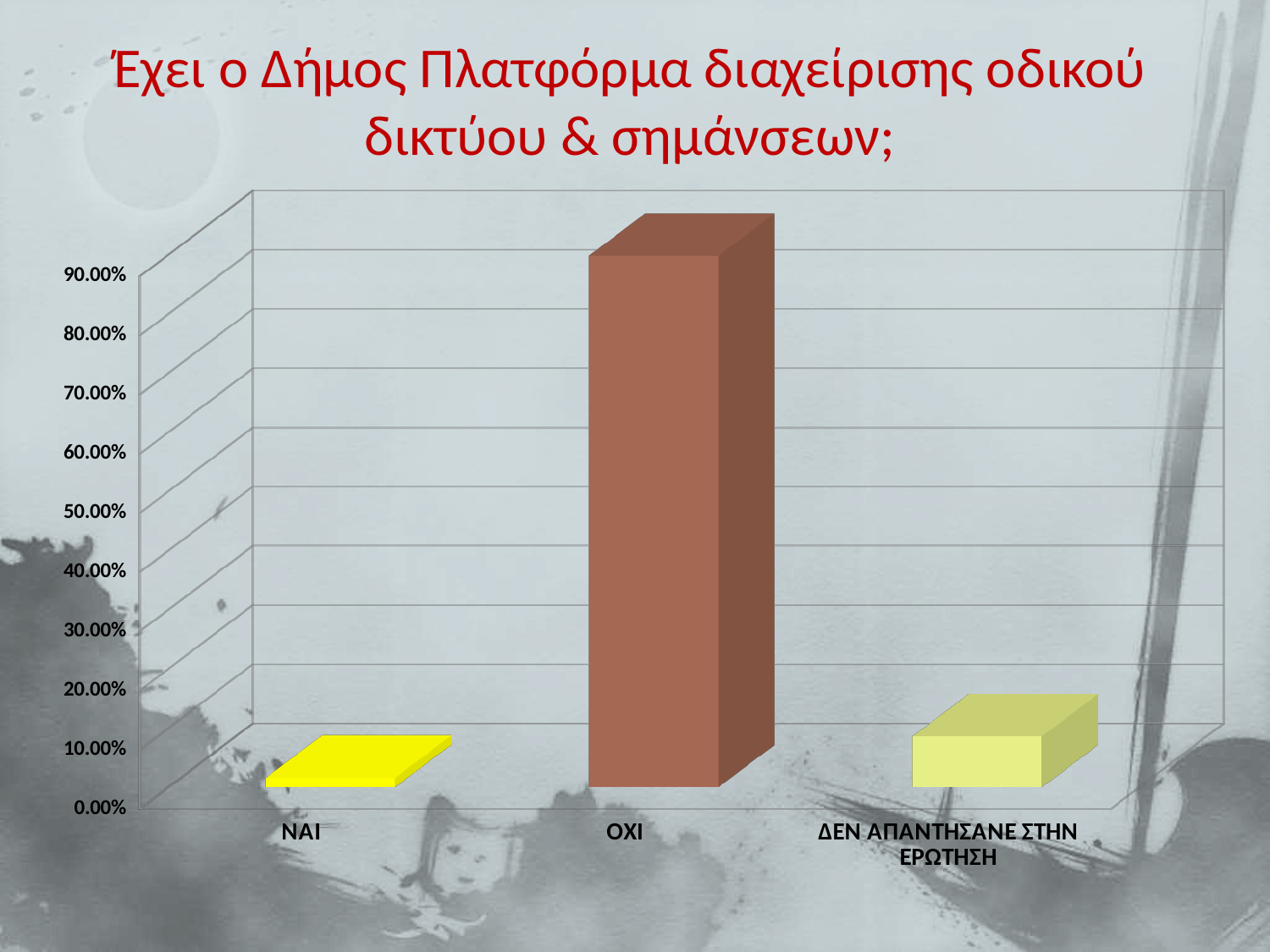
What colour is the bar for ΟΧΙ? Brown Is the value for ΝΑΙ greater or less than 10.00%? less How many categories are shown on the x axis of the chart? 3 Is the value for ΟΧΙ greater or less than 80.00%? greater Which category has the highest value in the chart? ΟΧΙ Which category has the lowest value in the chart? ΝΑΙ Is the value for ΟΧΙ greater or less than 50.00%? greater What is the title of the slide above the chart? Έχει ο Δήμος Πλατφόρμα διαχείρισης οδικού δικτύου & σημάνσεων; Which is larger, the value for ΟΧΙ or the value for ΝΑΙ? ΟΧΙ What kind of chart is shown on the slide? Bar chart Which is larger, the value for ΔΕΝ ΑΠΑΝΤΗΣΑΝΕ ΣΤΗΝ ΕΡΩΤΗΣΗ or the value for ΝΑΙ? ΔΕΝ ΑΠΑΝΤΗΣΑΝΕ ΣΤΗΝ ΕΡΩΤΗΣΗ